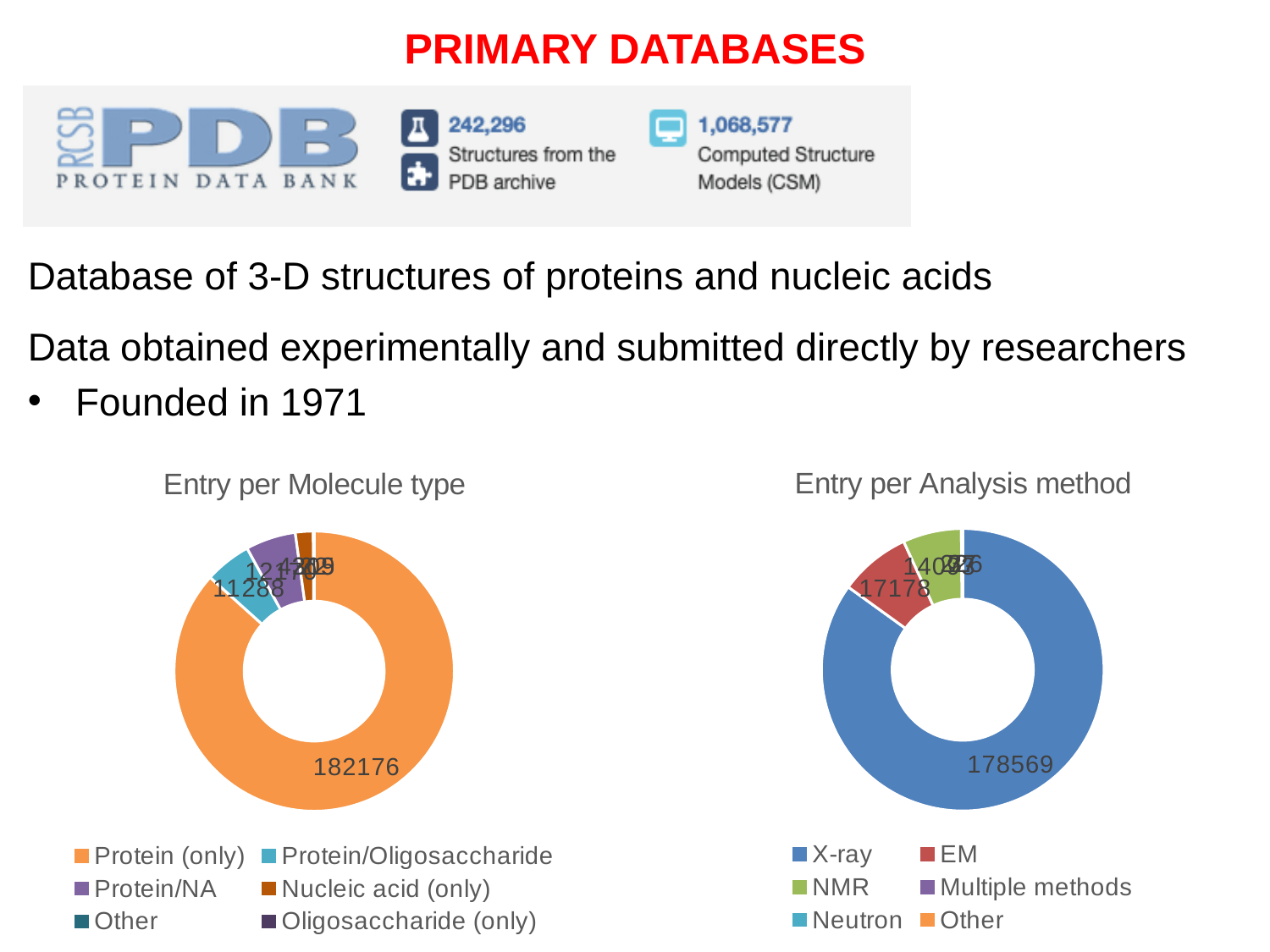
In the 'Entry per Molecule type' chart, what is the value for Protein/Oligosaccharide? 11288 In the 'Entry per Analysis method' chart, which is larger, X-ray or EM? X-ray What kind of chart is the 'Entry per Analysis method' chart? Doughnut (pie) chart What is the title of the chart on the right side of the slide? Entry per Analysis method In the 'Entry per Molecule type' chart, which molecule type has the largest number of entries? Protein (only) In the 'Entry per Molecule type' chart, what is the value for Protein (only)? 182176 How many categories does the legend of the 'Entry per Molecule type' chart list? 6 In the 'Entry per Analysis method' chart, what is the difference between X-ray and EM? 161391 In the 'Entry per Analysis method' chart, what is the value for EM? 17178 In the 'Entry per Molecule type' chart, what is the difference between Protein (only) and Protein/Oligosaccharide? 170888 In the 'Entry per Analysis method' chart, what is the value for X-ray? 178569 In the 'Entry per Analysis method' chart, which analysis method has the largest number of entries? X-ray